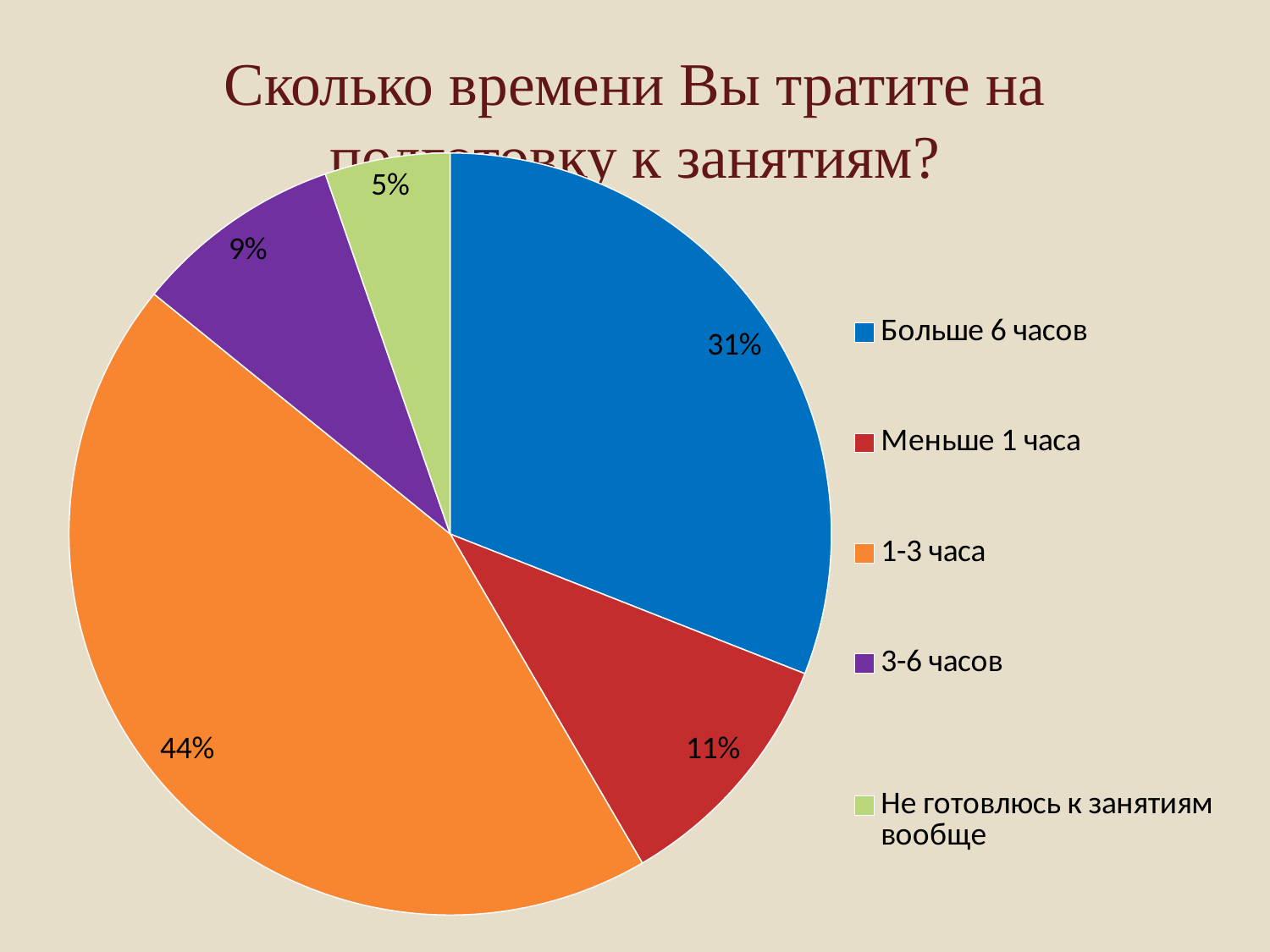
What share of the pie is labelled for "Не готовлюсь к занятиям вообще"? 5% Which slice is larger, "Меньше 1 часа" or "3-6 часов"? Меньше 1 часа Which category has the largest slice of the pie? 1-3 часа What share of the pie is labelled for "3-6 часов"? 9% How many categories does the pie chart have? 5 What share of the pie is labelled for "1-3 часа"? 44% Which colour represents "3-6 часов" in the legend? Purple What is the difference in percentage points between the "1-3 часа" slice and the "Больше 6 часов" slice? 13% Which category has the smallest slice of the pie? Не готовлюсь к занятиям вообще What kind of chart is shown on the slide? Pie chart